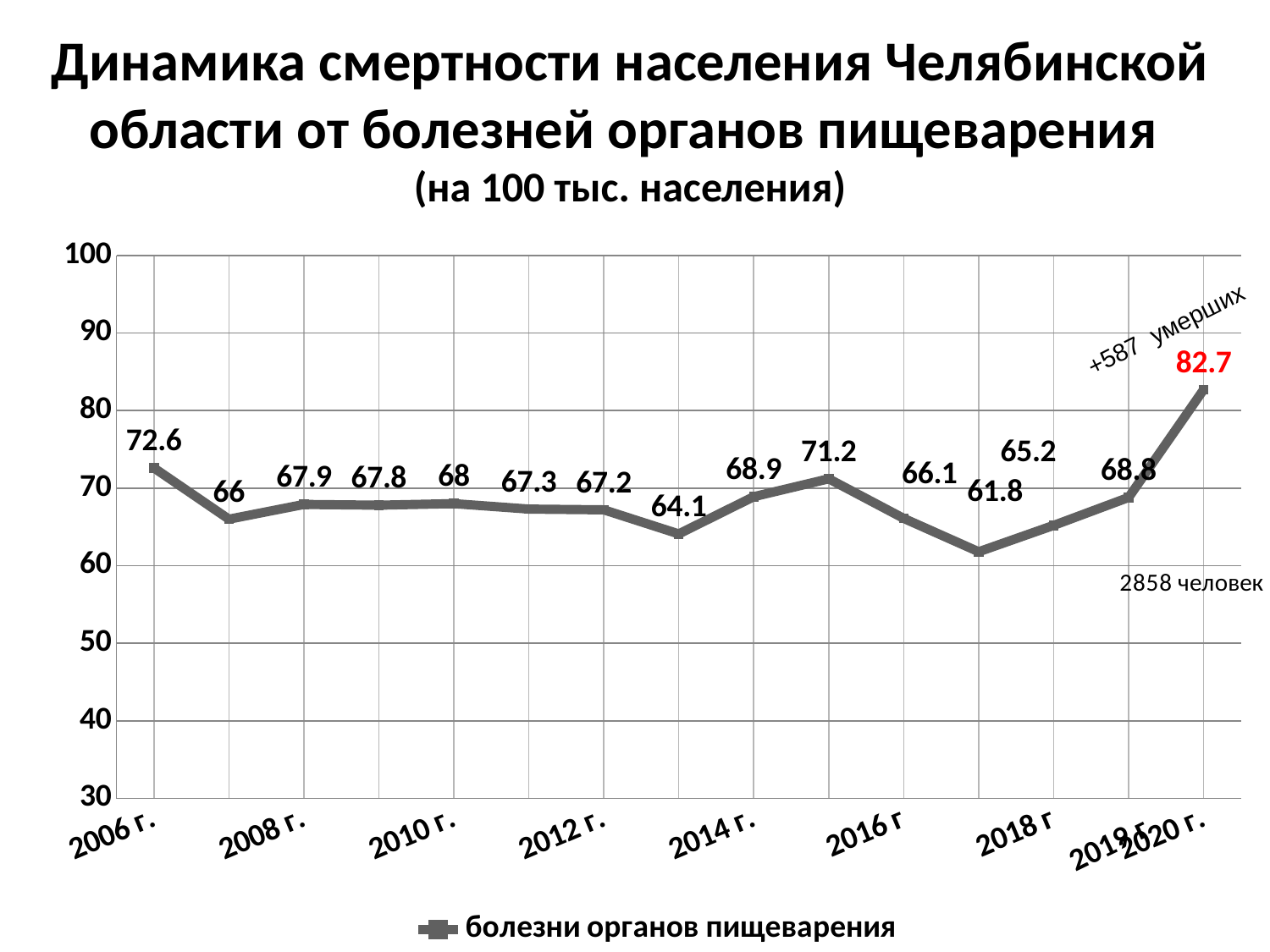
What is the difference between the values for 2020 г. and 2006 г.? 10.1 What is the value for 2006 г.? 72.6 What is the difference between the values for 2020 г. and 2019 г.? 13.9 What is the lowest value plotted on the chart? 61.8 What kind of chart is shown? line chart Which year has the highest value? 2020 г. What is the value for 2020 г.? 82.7 What is the value for 2010 г.? 68 Which is larger, the value for 2014 г. or for 2016 г? 2014 г. How many data points are plotted on the line? 15 How many series does the legend list? 1 Is the value for 2020 г. greater or less than 80? greater